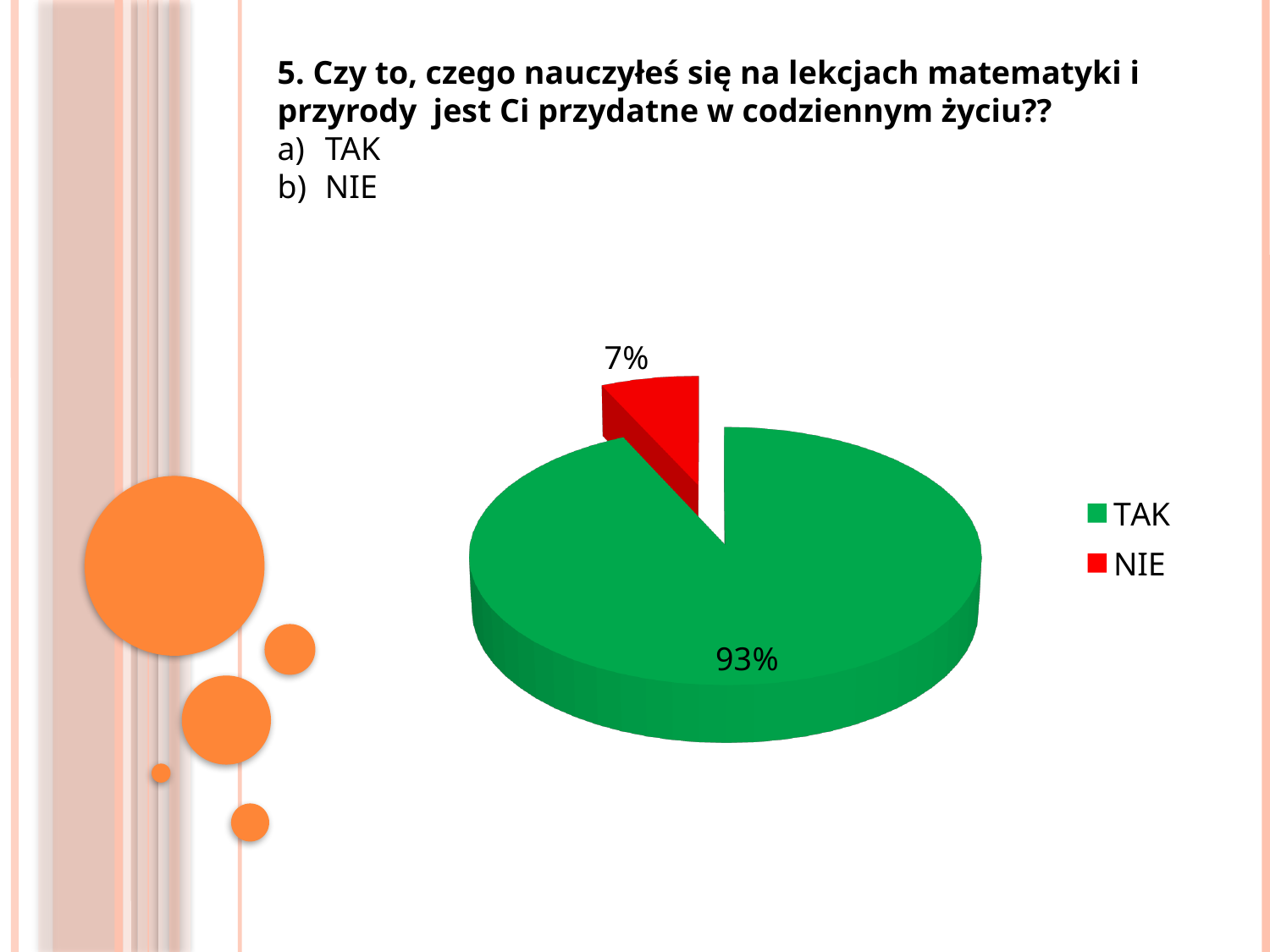
What kind of chart is shown on the slide? Pie chart Which category has the largest slice of the pie? TAK What colour is the TAK slice? Green What colour is the NIE slice? Red What share of the pie does TAK represent? 93% Which is larger, the TAK slice or the NIE slice? TAK What is the difference in percentage points between the TAK and NIE slices? 86 How many entries does the legend list? 2 Which category has the smallest slice of the pie? NIE What share of the pie does NIE represent? 7% How many slices does the pie chart have? 2